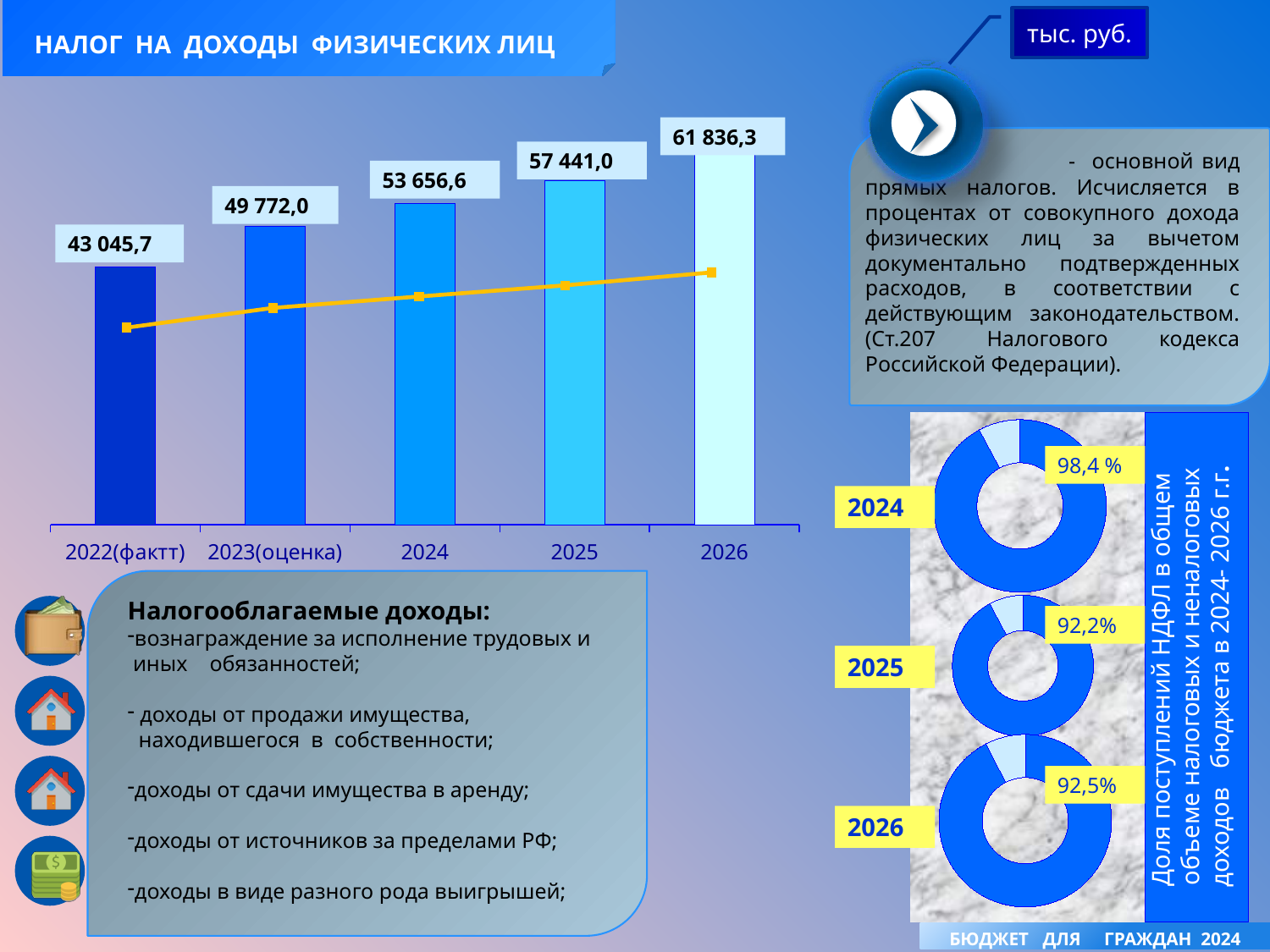
In the donut charts on the right showing the share of НДФЛ in budget revenues, which year has the lowest share? 2025 In the bar chart 'НАЛОГ НА ДОХОДЫ ФИЗИЧЕСКИХ ЛИЦ', what is the value for 2024? 53 656,6 In the bar chart 'НАЛОГ НА ДОХОДЫ ФИЗИЧЕСКИХ ЛИЦ', what is the value for 2022(факт)? 43 045,7 In the bar chart 'НАЛОГ НА ДОХОДЫ ФИЗИЧЕСКИХ ЛИЦ', what is the difference between the values for 2025 and 2024? 3 784,4 In the bar chart 'НАЛОГ НА ДОХОДЫ ФИЗИЧЕСКИХ ЛИЦ', what is the value for 2026? 61 836,3 In the donut charts on the right showing the share of НДФЛ in budget revenues, what is the share for 2024? 98,4 % In the bar chart 'НАЛОГ НА ДОХОДЫ ФИЗИЧЕСКИХ ЛИЦ', do the values rise or fall from 2022(факт) to 2026? rise In the bar chart 'НАЛОГ НА ДОХОДЫ ФИЗИЧЕСКИХ ЛИЦ', which year has the highest value? 2026 What unit is indicated for the values in the bar chart 'НАЛОГ НА ДОХОДЫ ФИЗИЧЕСКИХ ЛИЦ'? тыс. руб. In the bar chart 'НАЛОГ НА ДОХОДЫ ФИЗИЧЕСКИХ ЛИЦ', what is the difference between the values for 2026 and 2022(факт)? 18 790,6 In the bar chart 'НАЛОГ НА ДОХОДЫ ФИЗИЧЕСКИХ ЛИЦ', how many years are shown on the x axis? 5 In the bar chart 'НАЛОГ НА ДОХОДЫ ФИЗИЧЕСКИХ ЛИЦ', which year has the lowest value? 2022(факт)